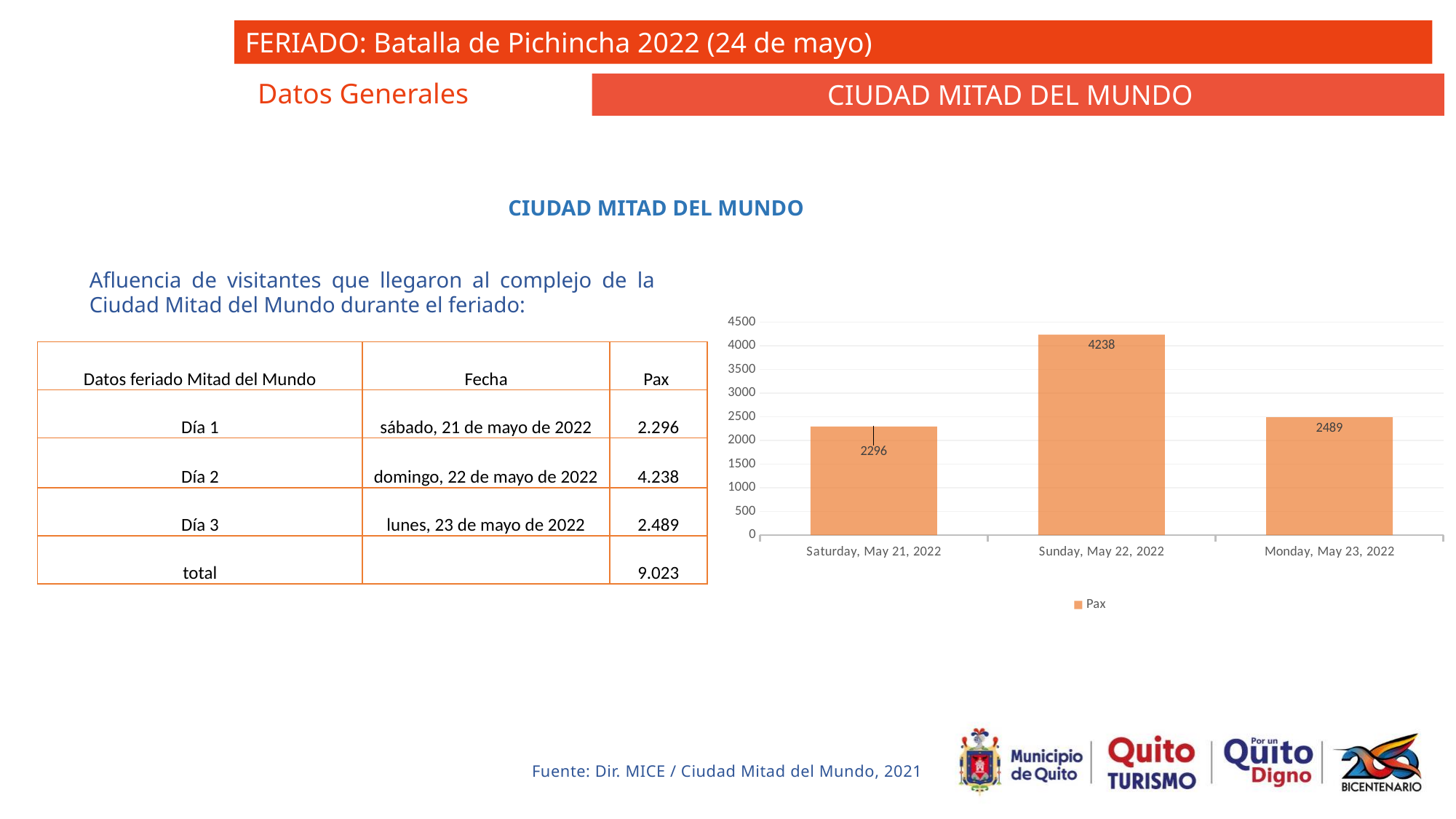
What kind of chart is shown on the slide? bar chart Which day has the highest Pax value in the chart? Sunday, May 22, 2022 What is the Pax value for Monday, May 23, 2022 in the chart? 2489 Which has a larger Pax value: Monday, May 23, 2022 or Saturday, May 21, 2022? Monday, May 23, 2022 What is the difference in Pax between Sunday, May 22, 2022 and Saturday, May 21, 2022? 1942 What is the difference in Pax between Monday, May 23, 2022 and Saturday, May 21, 2022? 193 Is the Pax value for Sunday, May 22, 2022 greater or less than 4000? greater What is the Pax value for Saturday, May 21, 2022 in the chart? 2296 Which day has the lowest Pax value in the chart? Saturday, May 21, 2022 What is the Pax value for Sunday, May 22, 2022 in the chart? 4238 How many days are shown on the x axis of the chart? 3 How many series does the chart legend list? 1